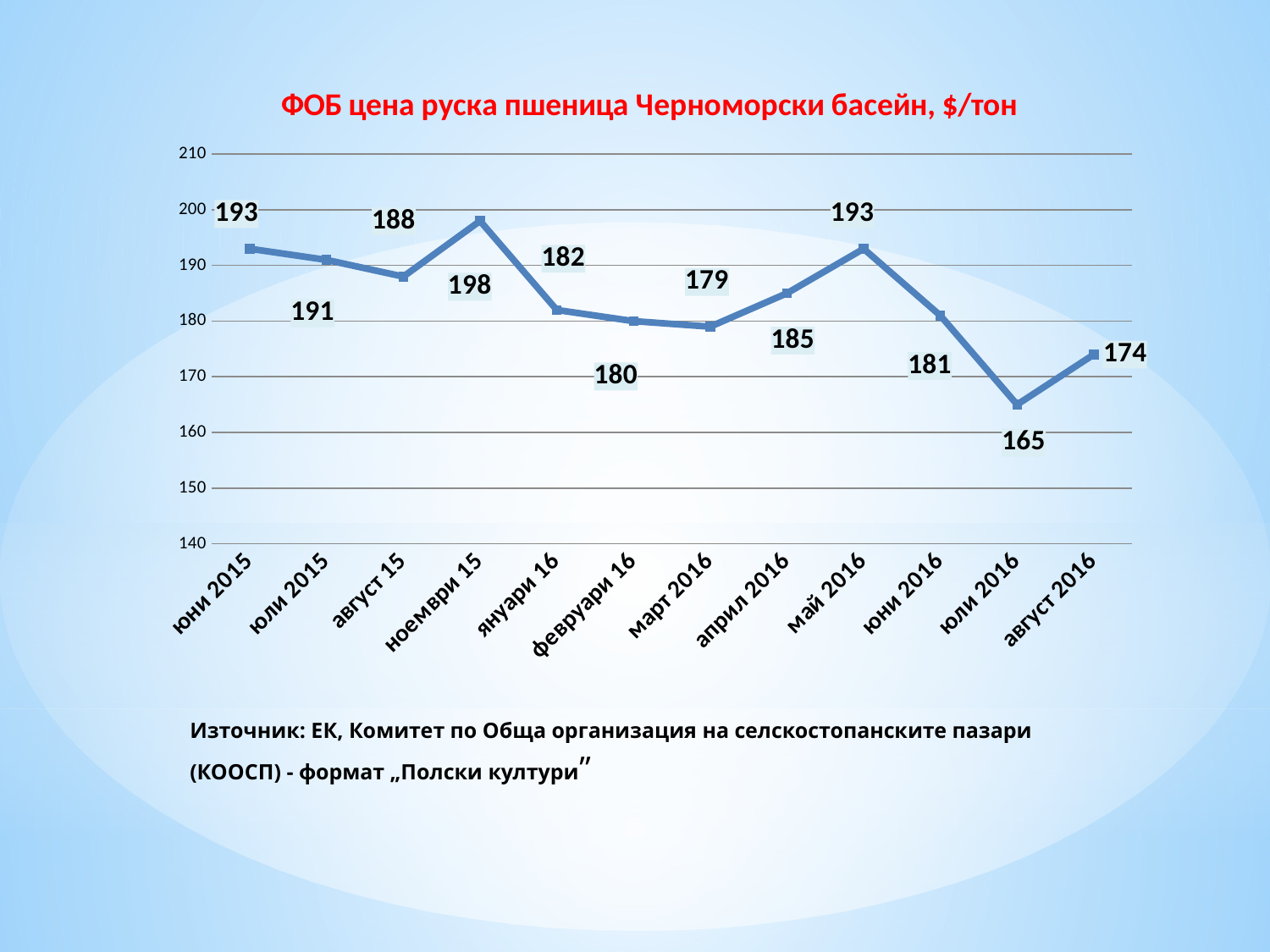
How many data points are plotted on the chart? 12 Which month has the lowest value on the chart? юли 2016 Which month has the highest value on the chart? ноември 15 What is the value for март 2016? 179 What type of chart is shown on the slide? line chart What is the difference between the values for ноември 15 and юли 2016? 33 What is the value for юли 2016? 165 What is the title of the chart? ФОБ цена руска пшеница Черноморски басейн, $/тон What is the FOB price of Russian wheat for ноември 15? 198 What is the value for август 2016? 174 Does the value rise or fall from май 2016 to юли 2016? fall Which is larger, the value for април 2016 or the value for юни 2016? април 2016